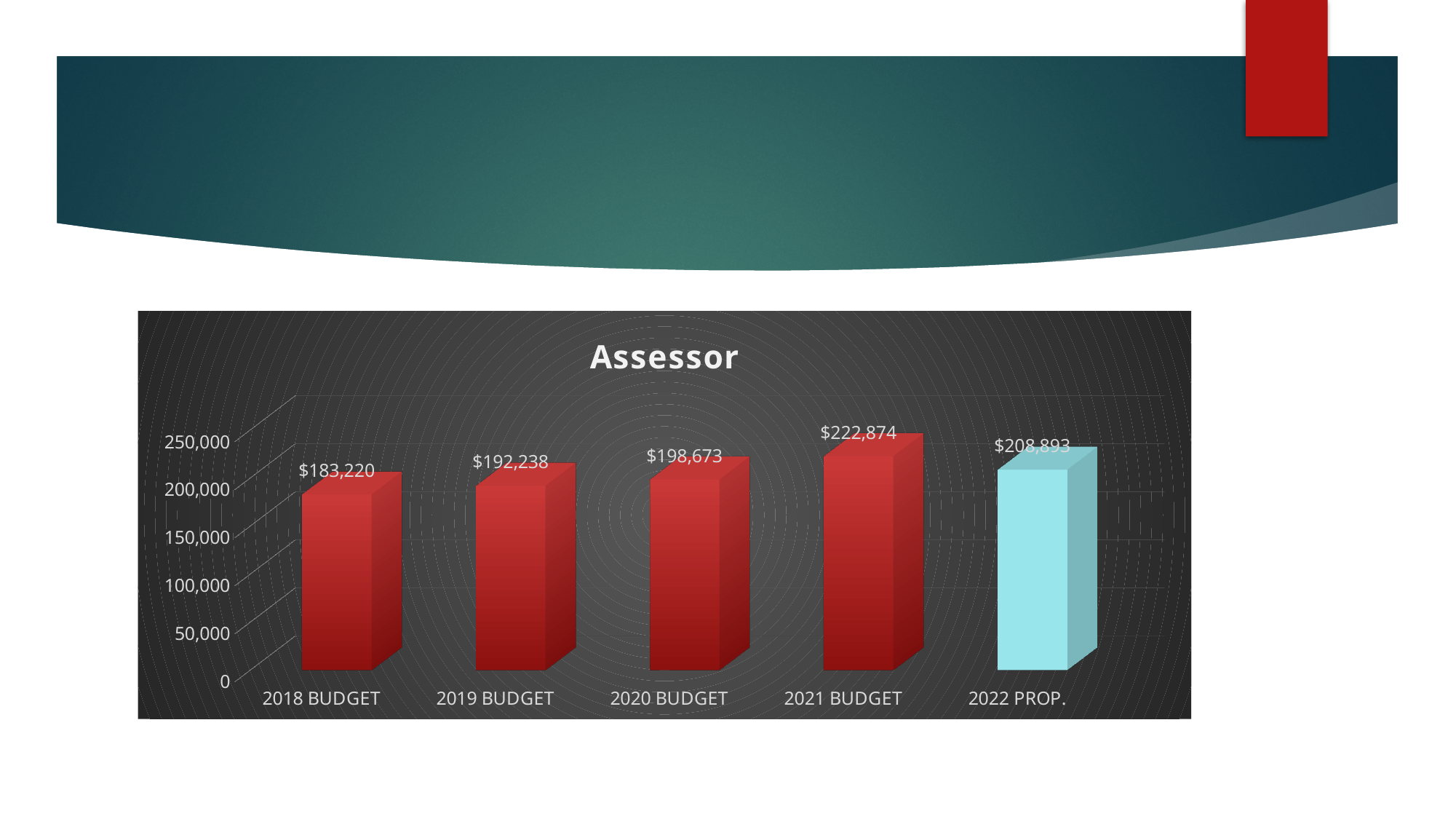
Which category has the lowest value? 2018 BUDGET What is the difference between the 2021 BUDGET and the 2022 PROP. values? $13,981 What is the value for 2022 PROP.? $208,893 What kind of chart is shown? bar chart Which category has the highest value? 2021 BUDGET How many categories are shown on the x axis? 5 What is the difference between the 2019 BUDGET and 2018 BUDGET values? $9,018 What is the title of the chart? Assessor Is the value for 2021 BUDGET greater or less than 200,000? greater What is the value for 2018 BUDGET? $183,220 What is the value for 2021 BUDGET? $222,874 Which is larger, the value for 2020 BUDGET or the value for 2022 PROP.? 2022 PROP.